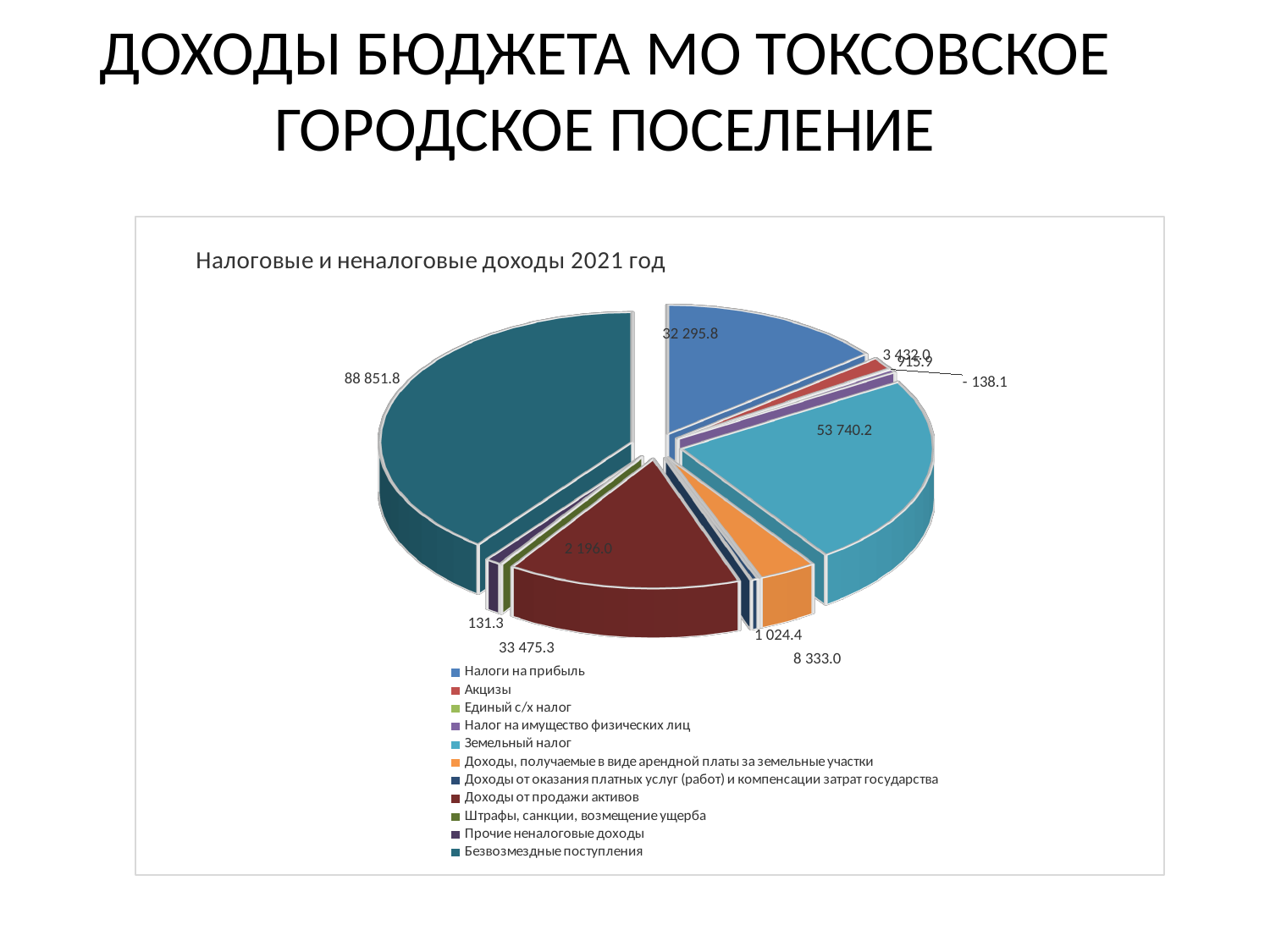
What is the value for Налоги на прибыль? 32 295.8 How many categories does the legend list? 11 Which category has the largest slice of the pie? Безвозмездные поступления What is the value for Земельный налог? 53 740.2 What is the difference between Земельный налог and Налоги на прибыль? 21 444.4 Which is larger, Земельный налог or Налоги на прибыль? Земельный налог What is the value for Доходы от продажи активов? 33 475.3 What is the value for Безвозмездные поступления? 88 851.8 What is the difference between Безвозмездные поступления and Земельный налог? 35 111.6 What is the title of the chart? Налоговые и неналоговые доходы 2021 год What kind of chart is shown on the slide? pie chart What is the value for Доходы, получаемые в виде арендной платы за земельные участки? 8 333.0